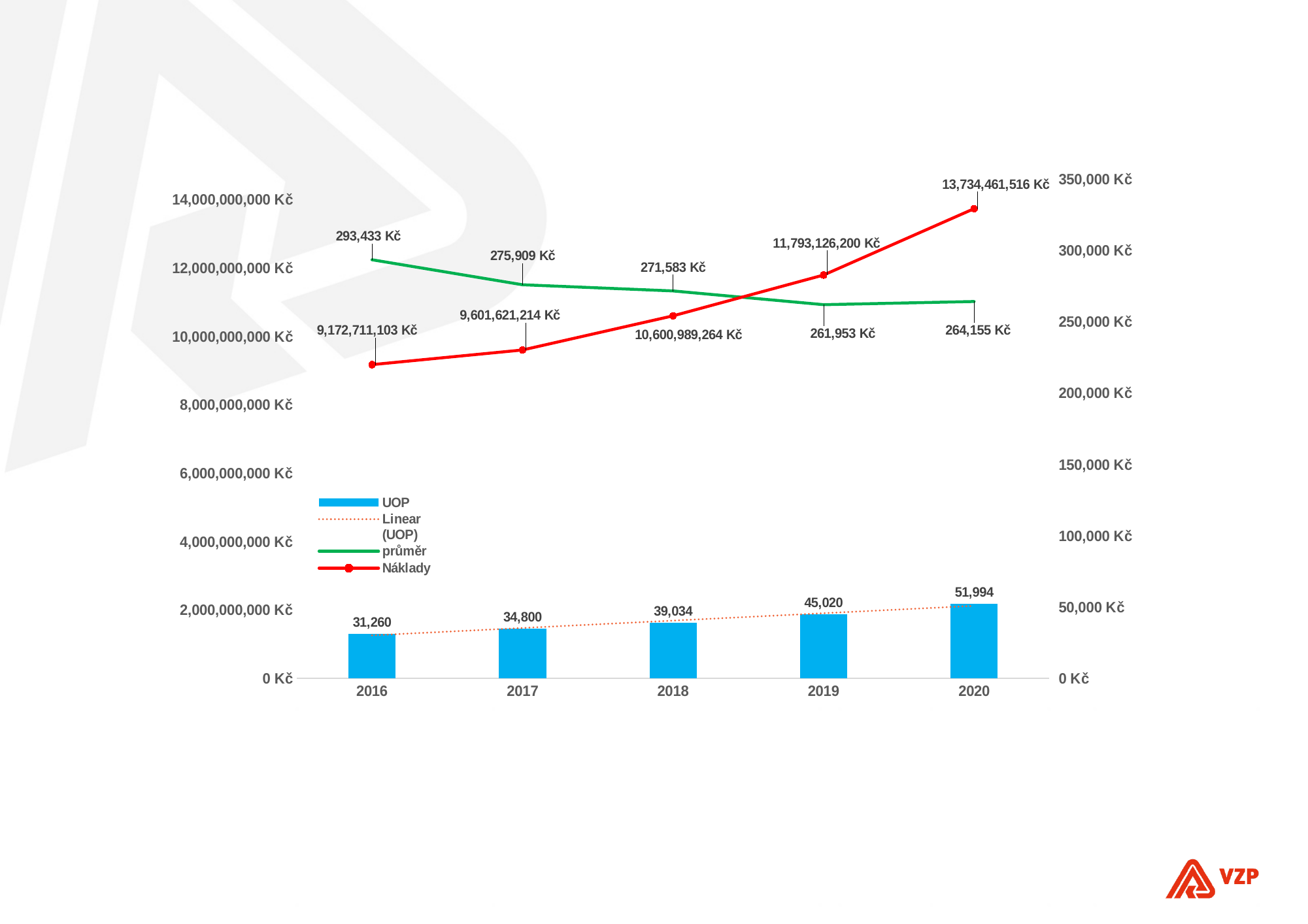
Which year has the lowest průměr value? 2019 Which is larger, the průměr value for 2017 or for 2018? 2017 What is the Náklady value for 2017? 9,601,621,214 Kč Which year has the highest UOP value? 2020 What is the průměr value for 2016? 293,433 Kč What colour are the UOP bars? blue What is the difference between the UOP values for 2020 and 2019? 6,974 Does the Náklady series rise or fall from 2016 to 2020? rise What is the UOP value for 2018? 39,034 How many entries does the legend list? 4 How many years are shown on the x axis? 5 What is the Náklady value for 2020? 13,734,461,516 Kč